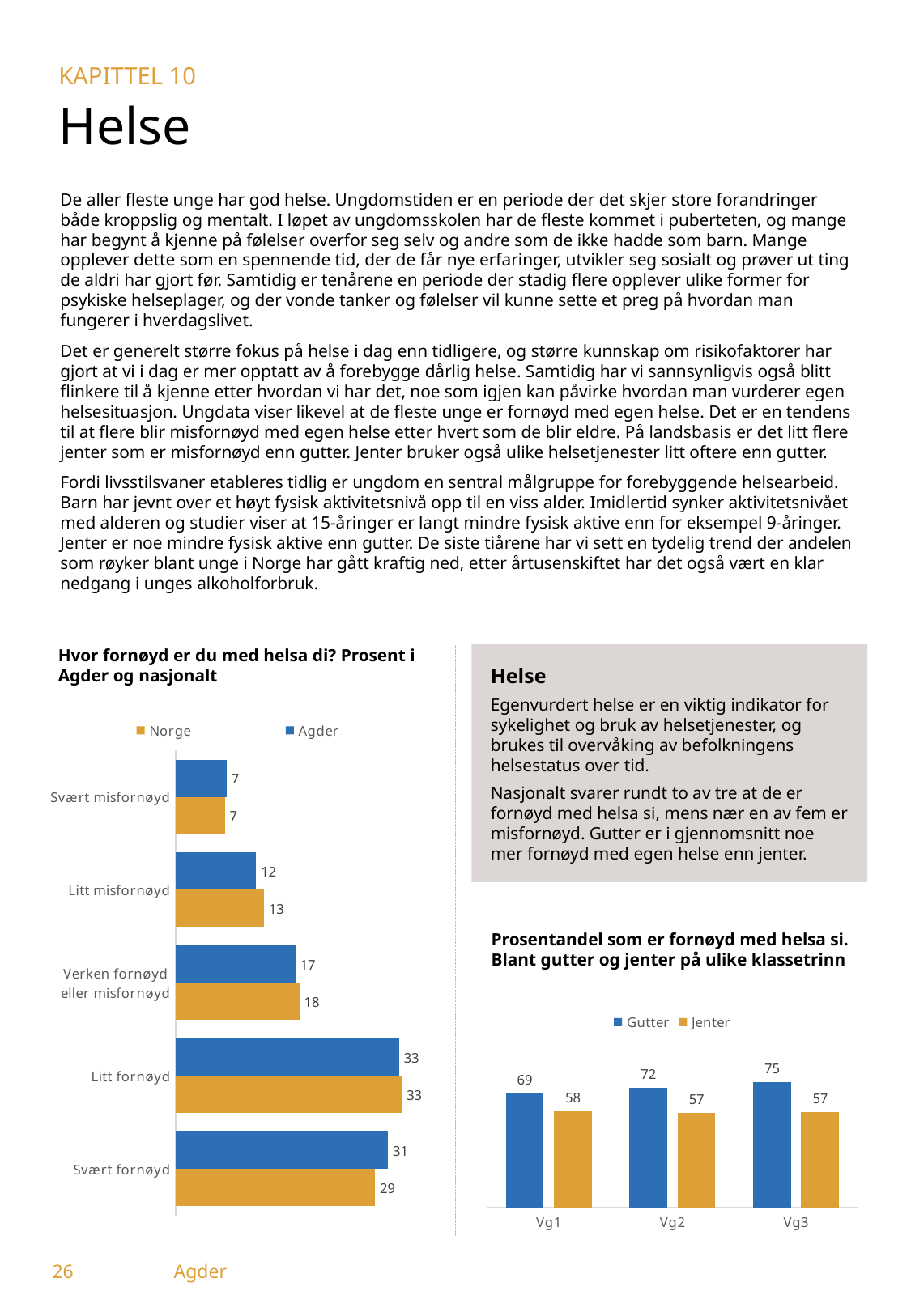
In the chart 'Hvor fornøyd er du med helsa di?', what is the value for Norge in the 'Litt misfornøyd' category? 13 In the chart 'Prosentandel som er fornøyd med helsa si', what is the difference between Gutter and Jenter at Vg3? 18 In the chart 'Prosentandel som er fornøyd med helsa si', what is the value for Jenter at Vg1? 58 In the chart 'Prosentandel som er fornøyd med helsa si', do the values for Gutter rise or fall from Vg1 to Vg3? rise In the chart 'Hvor fornøyd er du med helsa di?', which category has the highest value for Agder? Litt fornøyd In the chart 'Hvor fornøyd er du med helsa di?', what is the value for Agder in the 'Svært fornøyd' category? 31 In the chart 'Hvor fornøyd er du med helsa di?', which category has the lowest value for Norge? Svært misfornøyd In the chart 'Prosentandel som er fornøyd med helsa si', what is the value for Gutter at Vg2? 72 In the chart 'Hvor fornøyd er du med helsa di?', how many categories are shown? 5 In the chart 'Hvor fornøyd er du med helsa di?', what is the difference between Agder and Norge in the 'Svært fornøyd' category? 2 What kind of chart is 'Prosentandel som er fornøyd med helsa si'? bar chart In the chart 'Hvor fornøyd er du med helsa di?', how many series does the legend list? 2